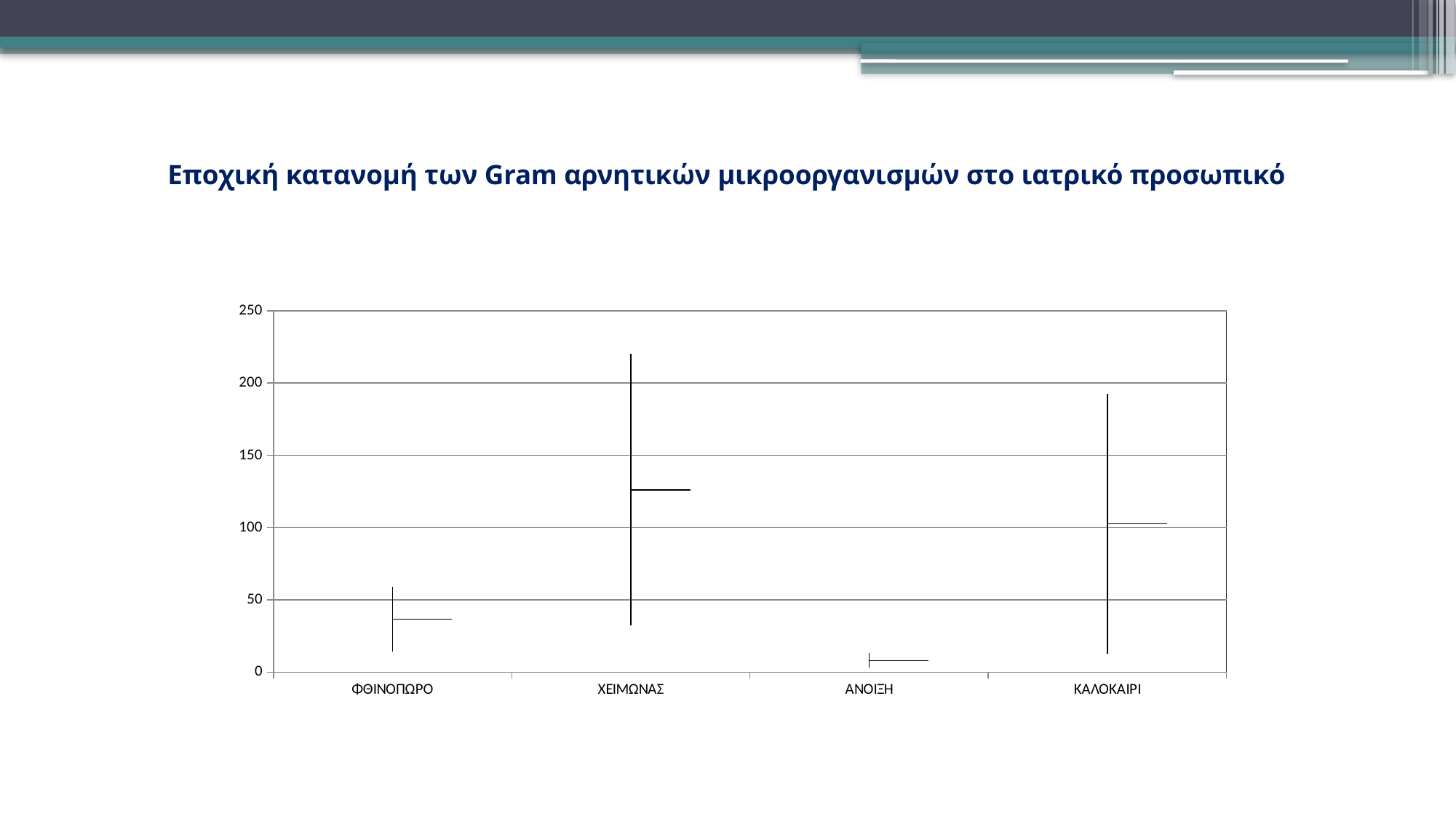
Which has a higher upper value, ΧΕΙΜΩΝΑΣ or ΚΑΛΟΚΑΙΡΙ? ΧΕΙΜΩΝΑΣ Is the horizontal marker value for ΑΝΟΙΞΗ greater or less than 50? less Which category has the highest upper value in the chart? ΧΕΙΜΩΝΑΣ Is the horizontal marker value for ΧΕΙΜΩΝΑΣ greater or less than 100? greater How many categories are shown on the x axis of the chart? 4 What is the maximum value shown on the y axis of the chart? 250 Which category has the lowest values in the chart? ΑΝΟΙΞΗ Is the upper value for ΧΕΙΜΩΝΑΣ greater or less than 200? greater What is the title of the slide above the chart? Εποχική κατανομή των Gram αρνητικών μικροοργανισμών στο ιατρικό προσωπικό Which has a higher horizontal marker value, ΦΘΙΝΟΠΩΡΟ or ΚΑΛΟΚΑΙΡΙ? ΚΑΛΟΚΑΙΡΙ